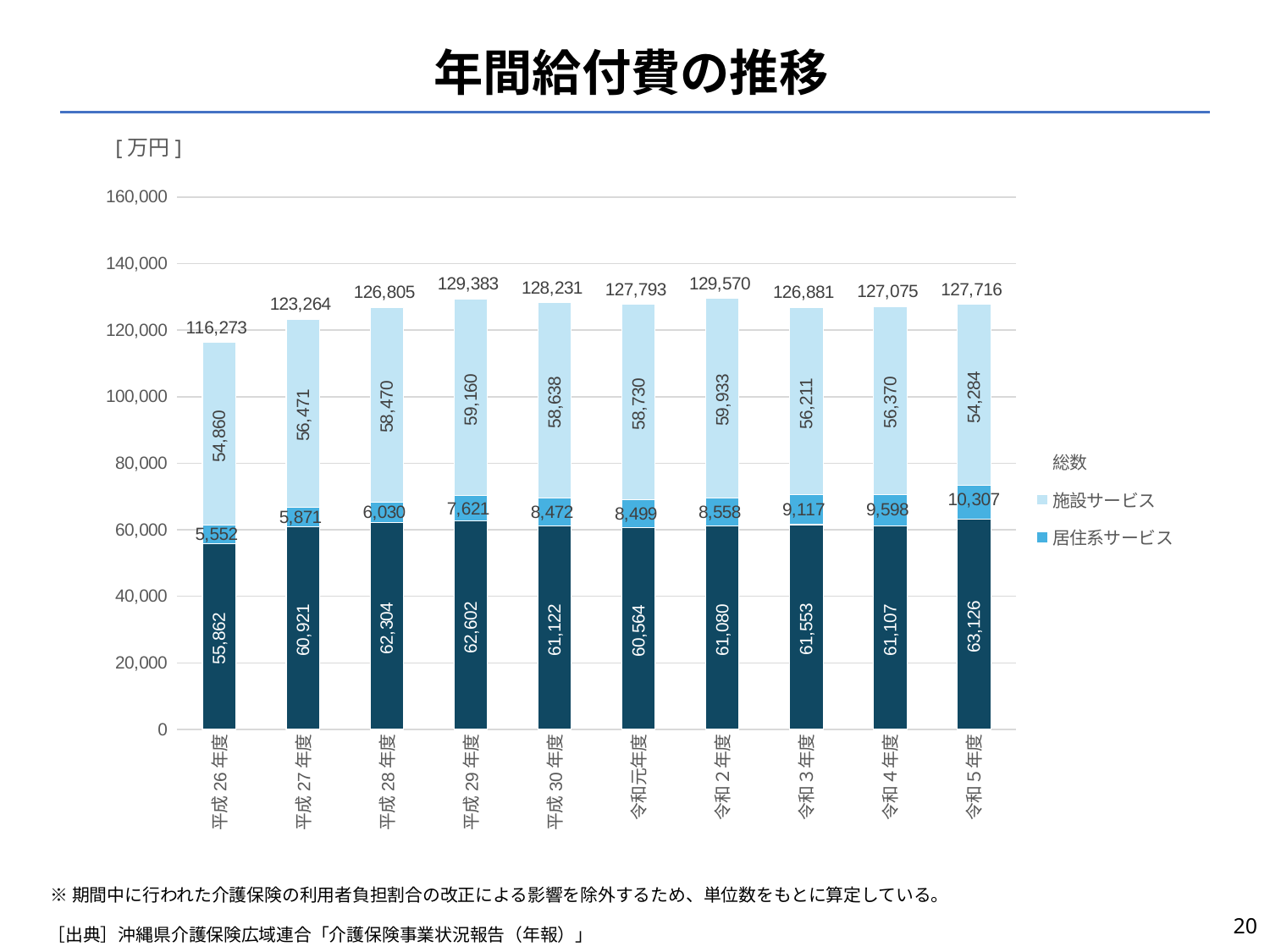
What is the difference between the 居住系サービス values for 令和5年度 and 平成26年度? 4,755 What is the 居住系サービス value for 令和5年度? 10,307 What is the total (総数) value for 平成26年度? 116,273 Which fiscal year has the lowest 施設サービス value? 令和5年度 What is the 施設サービス value for 令和2年度? 59,933 What kind of chart is shown on the slide? stacked bar chart How many entries does the legend list? 3 Which is larger, the total for 平成29年度 or the total for 平成30年度? 平成29年度 Which fiscal year has the lowest total (総数) value? 平成26年度 Which fiscal year has the highest total (総数) value? 令和2年度 Does the 居住系サービス value rise or fall from 平成26年度 to 令和5年度? rise How many fiscal years are shown on the x axis? 10